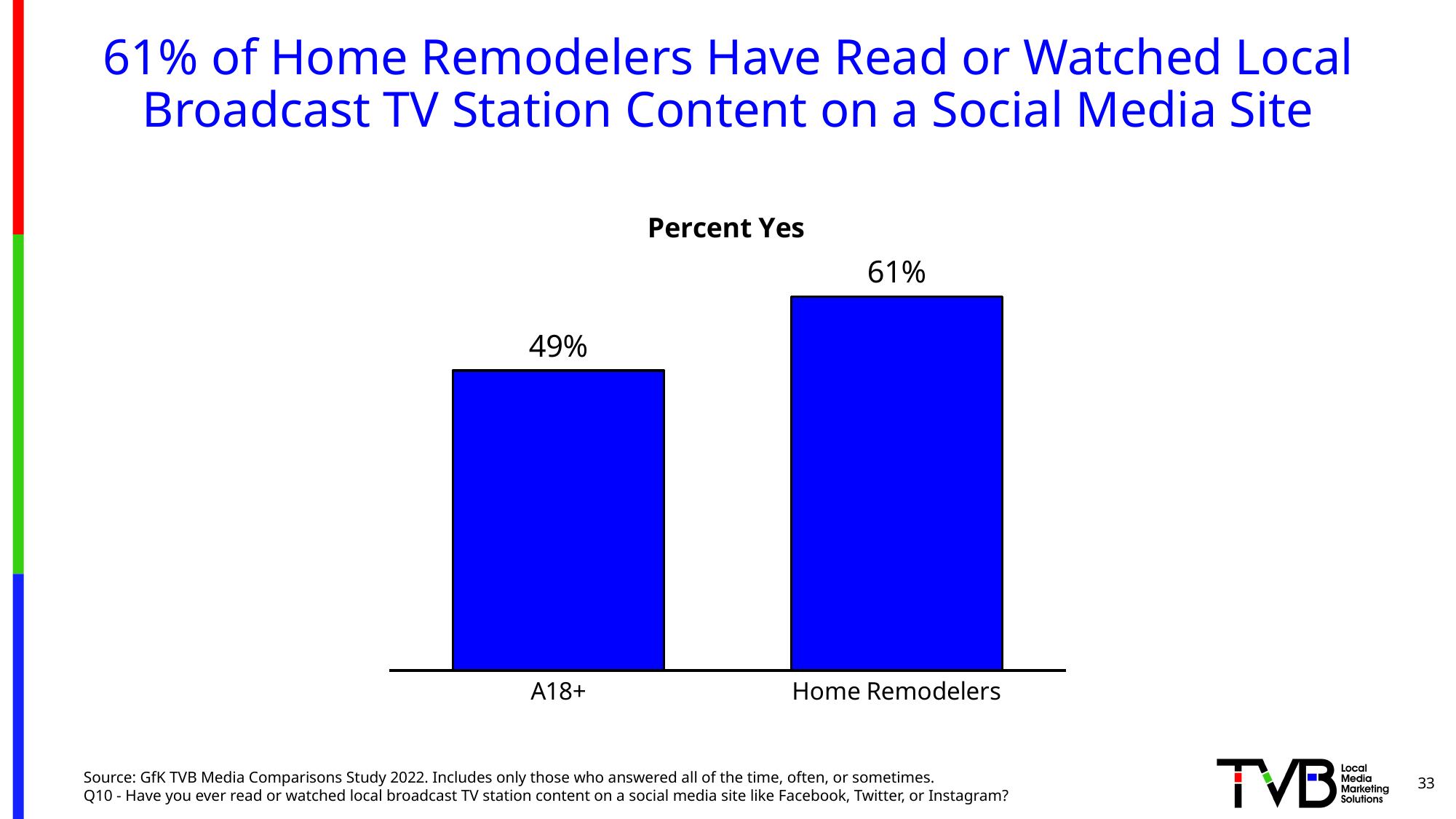
What is the difference between the values for Home Remodelers and A18+? 12 percentage points What is the title of the chart? Percent Yes Which category has the highest value? Home Remodelers Which category has the lowest value? A18+ What is the value for A18+? 49% What colour are the bars in the chart? Blue Do the values rise or fall from A18+ to Home Remodelers? Rise What kind of chart is shown on the slide? Bar chart How many categories are shown in the chart? 2 What is the value for Home Remodelers? 61% Which is larger, the value for A18+ or the value for Home Remodelers? Home Remodelers